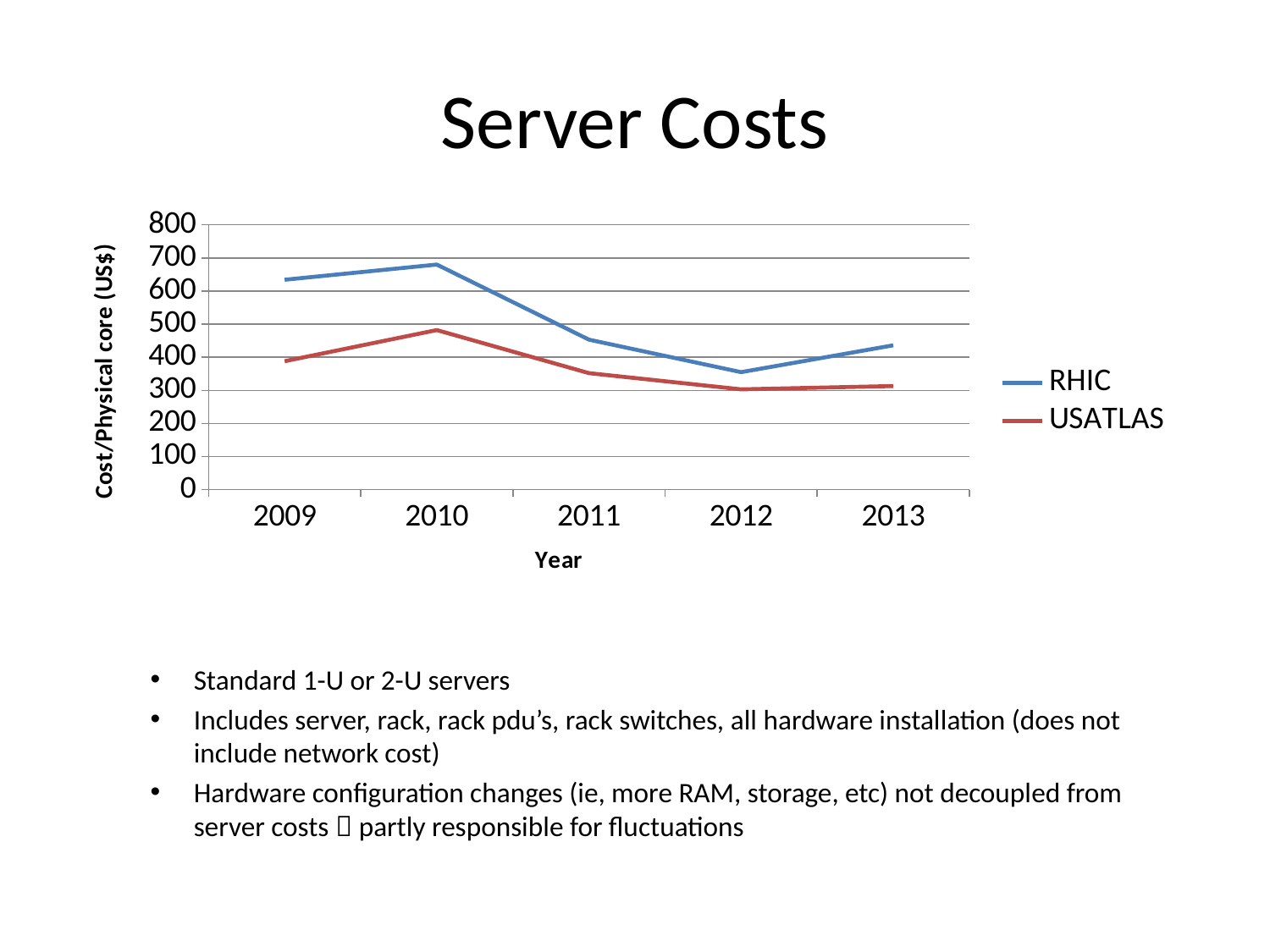
How many series does the legend list? 2 Is the USATLAS value for 2012 greater or less than 400? less In 2010, which series has the higher cost per physical core, RHIC or USATLAS? RHIC Is the RHIC value for 2012 greater or less than 400? less In which year is the RHIC cost per physical core lowest? 2012 How many years are plotted along the x axis? 5 Does the RHIC cost rise or fall from 2010 to 2012? fall Is the RHIC value for 2010 greater or less than 600? greater What kind of chart is shown on the slide? line chart What is the label on the y axis of the chart? Cost/Physical core (US$) In which year is the RHIC cost per physical core highest? 2010 In which year is the USATLAS cost per physical core highest? 2010